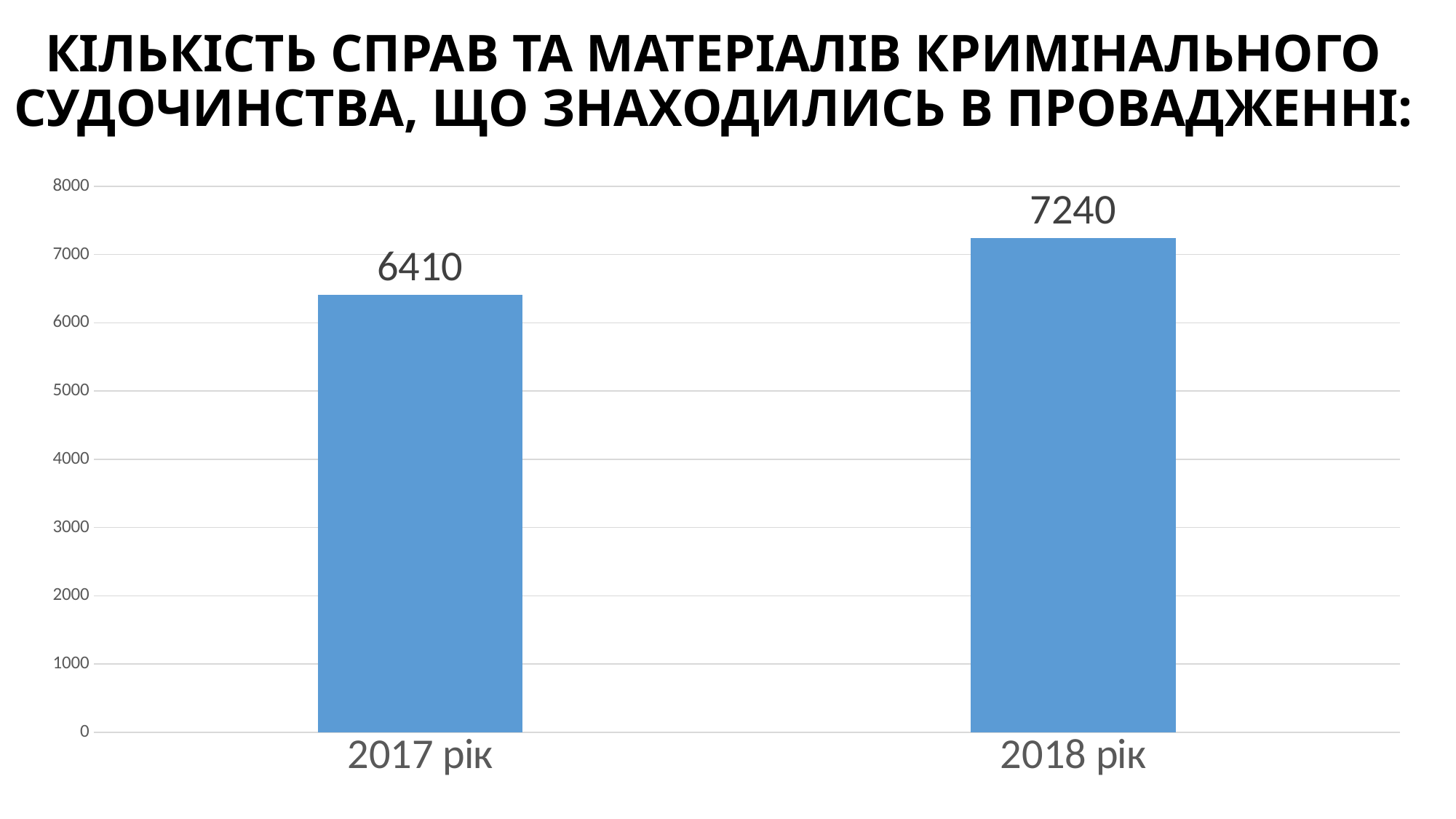
How many categories are shown on the x axis? 2 Which year has the highest value? 2018 рік Which year has the lowest value? 2017 рік What is the value for 2017 рік? 6410 Which is larger, the value for 2017 рік or the value for 2018 рік? 2018 рік Is the value for 2017 рік greater or less than 7000? less What is the highest value shown on the vertical axis? 8000 What is the value for 2018 рік? 7240 Is the value for 2018 рік greater or less than 7000? greater Do the values rise or fall from 2017 рік to 2018 рік? rise What kind of chart is shown on the slide? bar chart What is the difference between the values for 2018 рік and 2017 рік? 830